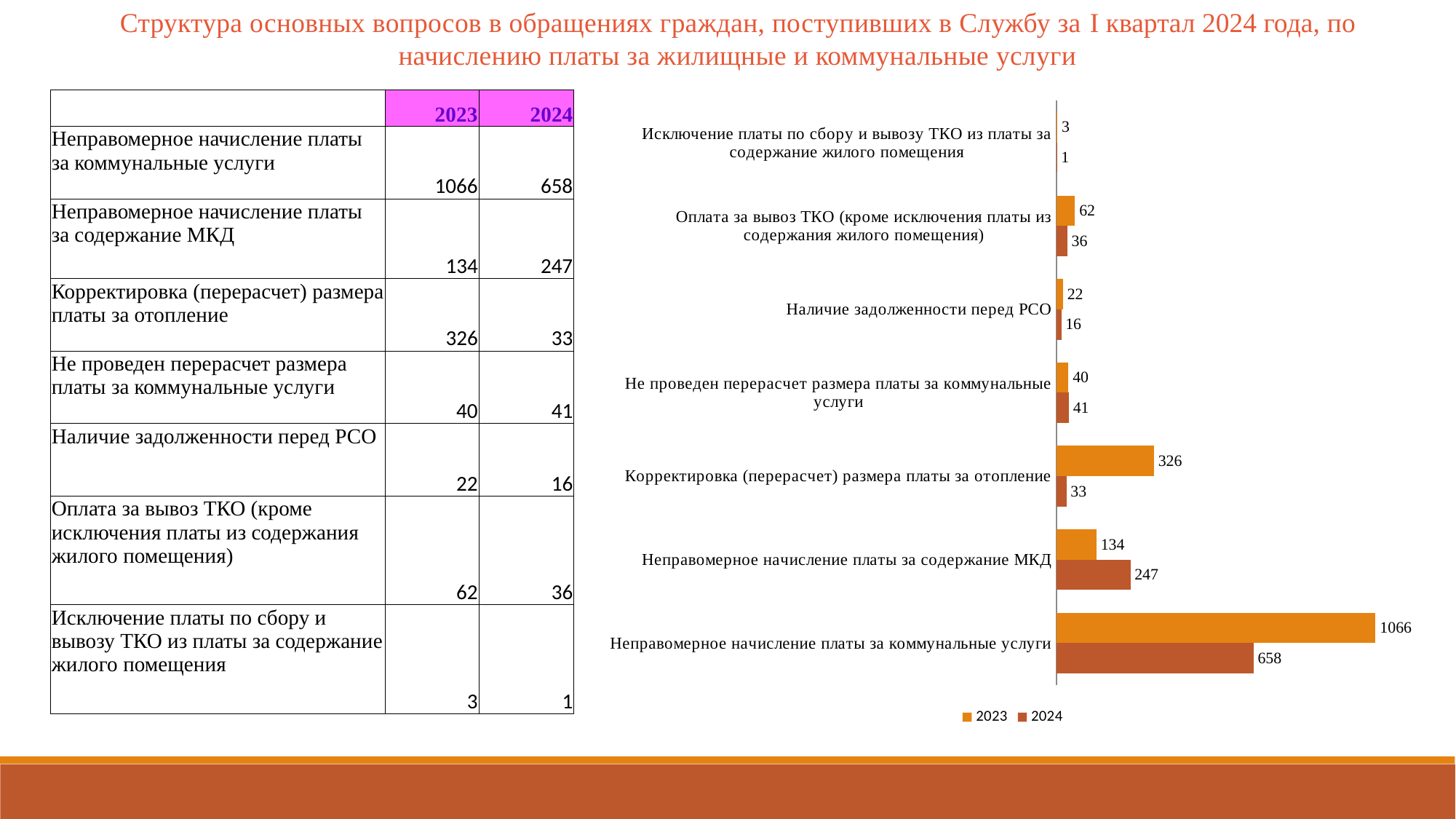
What type of chart is shown on the slide? bar chart Which category has the lowest 2023 value? Исключение платы по сбору и вывозу ТКО из платы за содержание жилого помещения What is the 2023 value for "Неправомерное начисление платы за коммунальные услуги"? 1066 What is the 2024 value for "Корректировка (перерасчет) размера платы за отопление"? 33 Which category has the highest 2024 value? Неправомерное начисление платы за коммунальные услуги How many series does the chart legend list? 2 For "Оплата за вывоз ТКО (кроме исключения платы из содержания жилого помещения)", which year has the larger value, 2023 or 2024? 2023 Which series is shown in the darker red-brown colour in the chart? 2024 What is the difference between the 2023 and 2024 values for "Корректировка (перерасчет) размера платы за отопление"? 293 How many categories are plotted on the chart? 7 What is the 2024 value for "Неправомерное начисление платы за содержание МКД"? 247 What is the difference between the 2023 and 2024 values for "Неправомерное начисление платы за коммунальные услуги"? 408